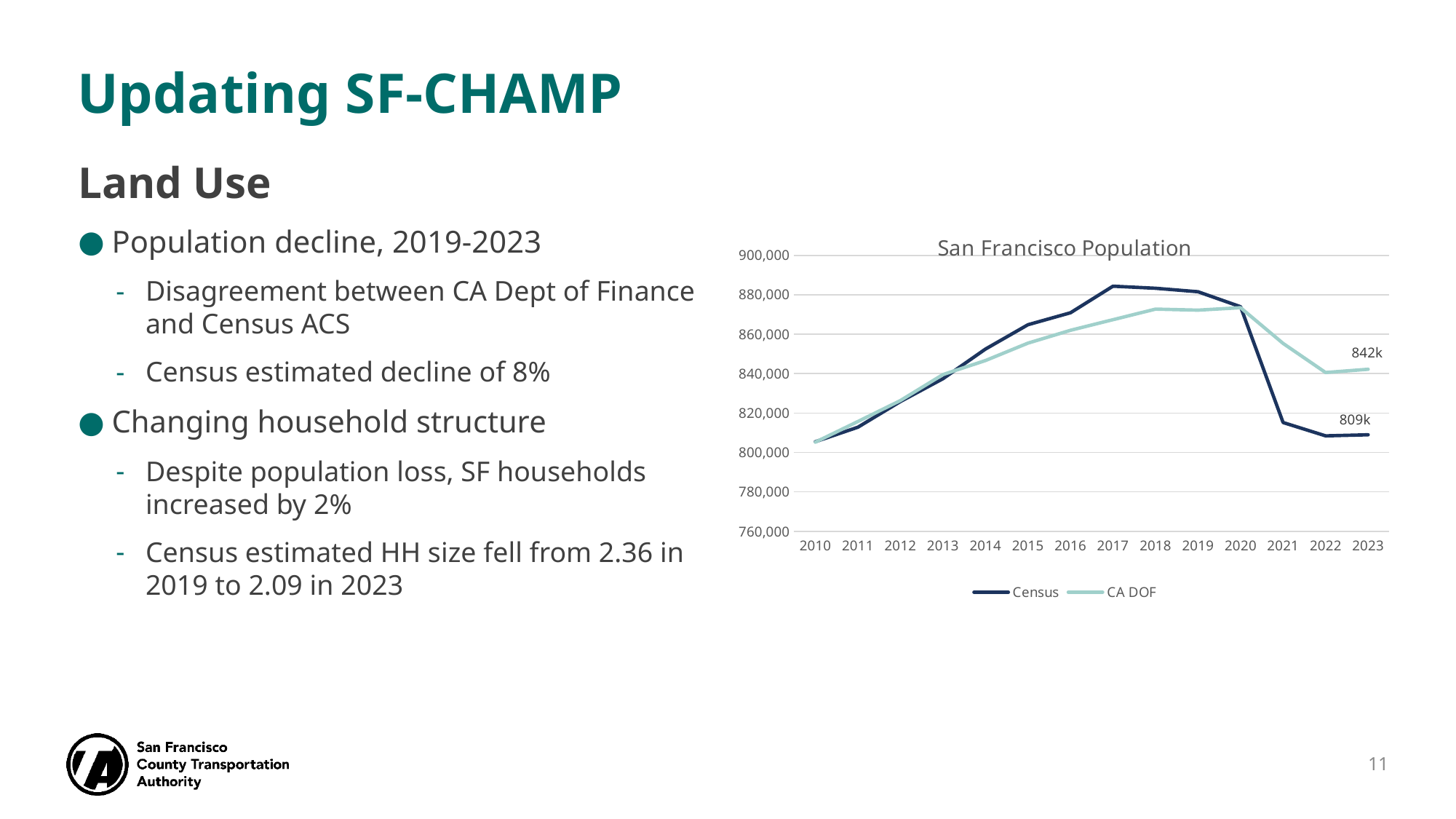
Is the Census value for 2021 greater or less than 820,000? less Is the Census value for 2017 greater or less than 880,000? greater What kind of chart is shown on the slide? Line chart What is the labelled value for the CA DOF series in 2023? 842k In 2023, which series shows the larger population, Census or CA DOF? CA DOF Is the CA DOF value for 2010 greater or less than 820,000? less What is the labelled value for the Census series in 2023? 809k What is the title of the chart? San Francisco Population How many years are shown on the x axis of the chart? 14 Does the Census series rise or fall between 2020 and 2021? Fall How many series does the chart's legend list? 2 In which year does the Census series reach its highest value? 2017